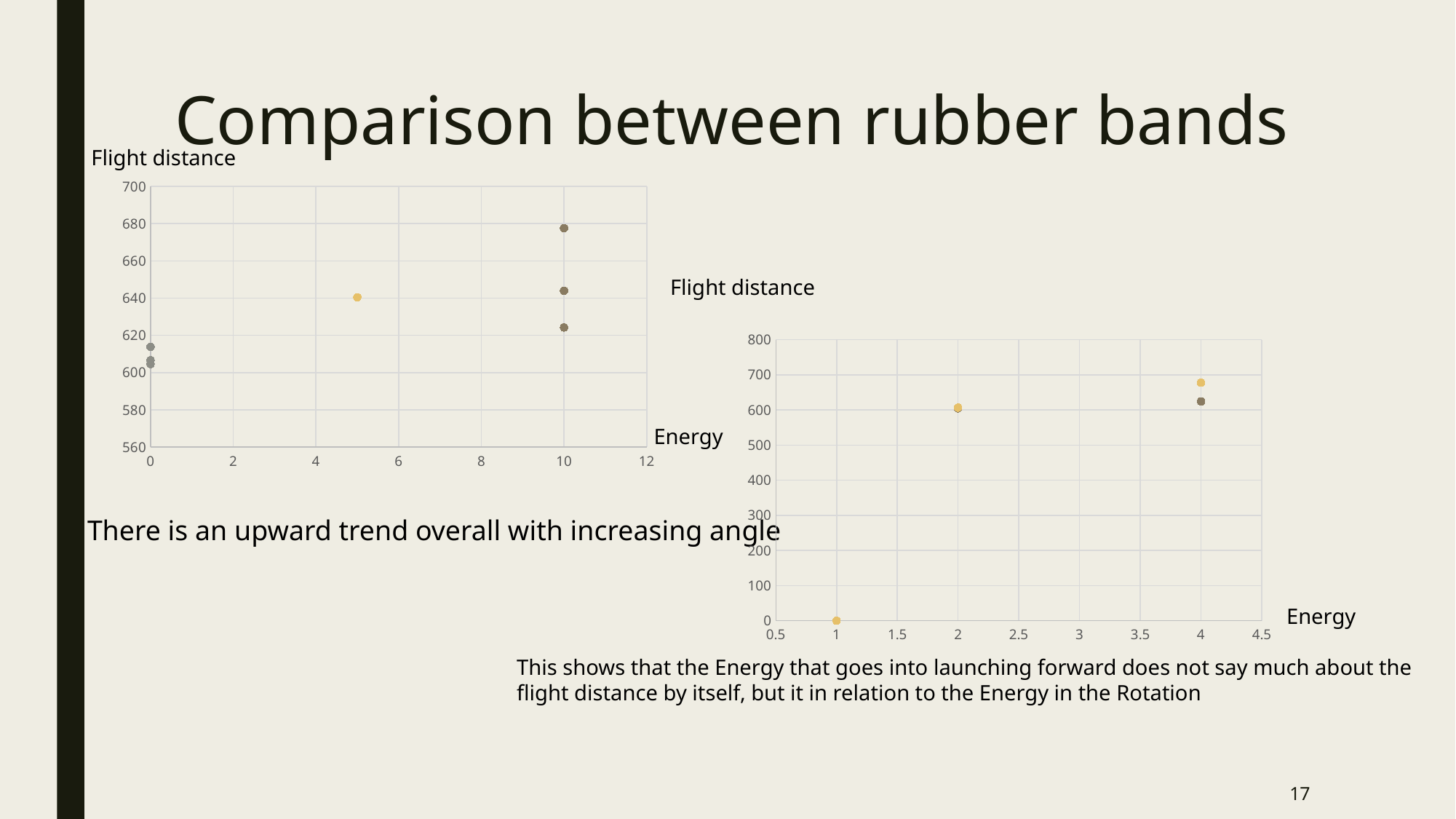
What is the title of the right chart? Flight distance In the left chart, is the point at Energy 5 greater or less than 620 on the Flight distance axis? greater What kind of chart is the chart on the left of the slide? scatter chart In the right chart, is the Flight distance of the points at Energy 2 greater or less than 500? greater In the left chart, how many points are plotted at Energy 10? 3 What kind of chart is the chart on the right of the slide? scatter chart In the right chart, is the highest point at Energy 4 greater or less than 700? less What is the label on the horizontal axis of the left chart? Energy In the right chart, do the Flight distance values generally rise or fall as Energy increases from 1 to 4? rise In the right chart, what is the Flight distance value of the point at Energy 1? 0